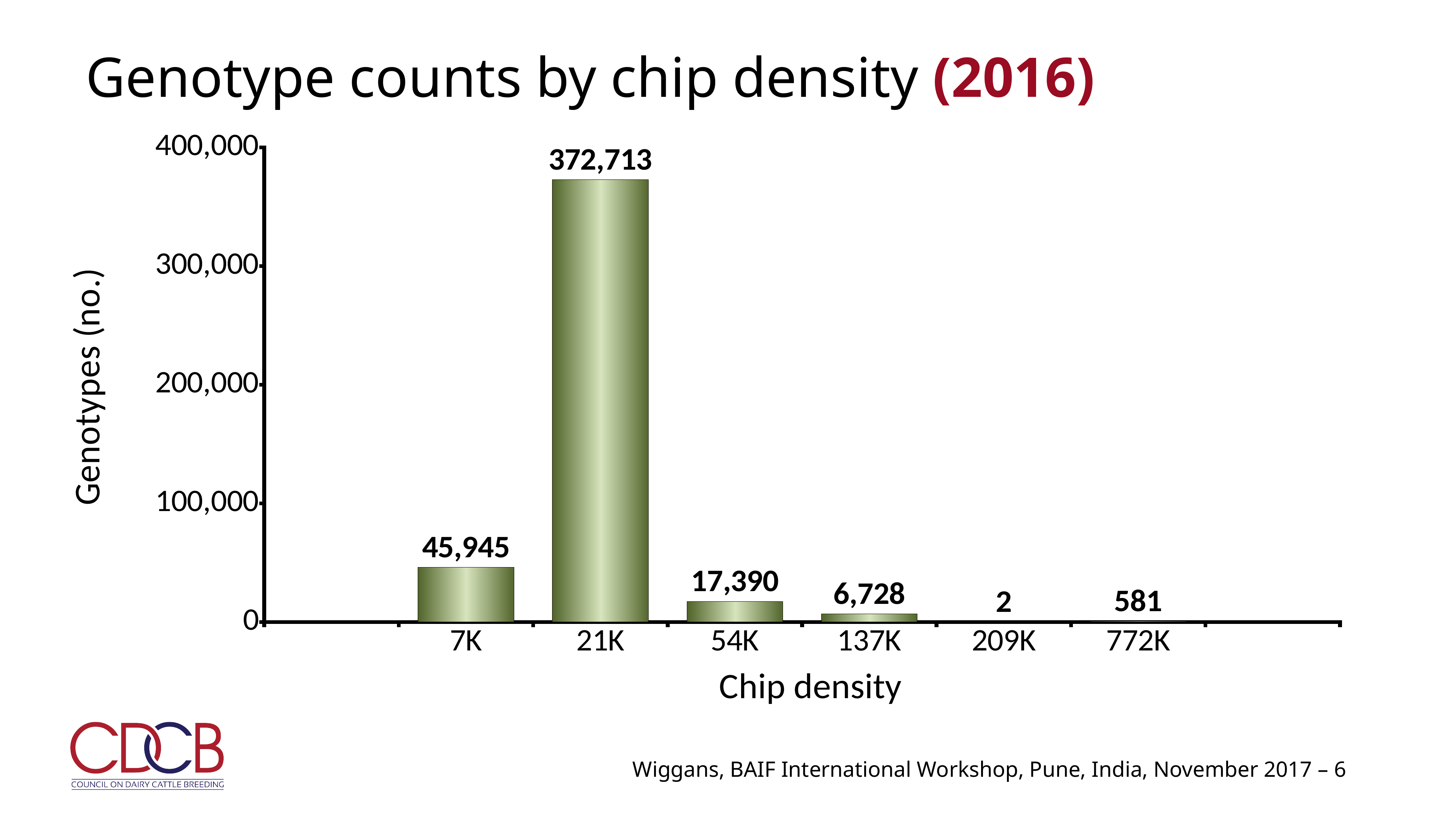
What is the difference in genotype count between the 54K and 137K chip densities? 10,662 What is the difference in genotype count between the 21K and 7K chip densities? 326,768 Which chip density has the highest genotype count? 21K What is the genotype count for the 21K chip density? 372,713 What is the genotype count for the 137K chip density? 6,728 Which has a larger genotype count, 54K or 772K? 54K Is the genotype count for 7K greater or less than 100,000? less What is the genotype count for the 7K chip density? 45,945 Which chip density has the lowest genotype count? 209K What type of chart is shown on the slide? bar chart How many chip density categories are shown on the x axis? 6 What is the genotype count for the 772K chip density? 581